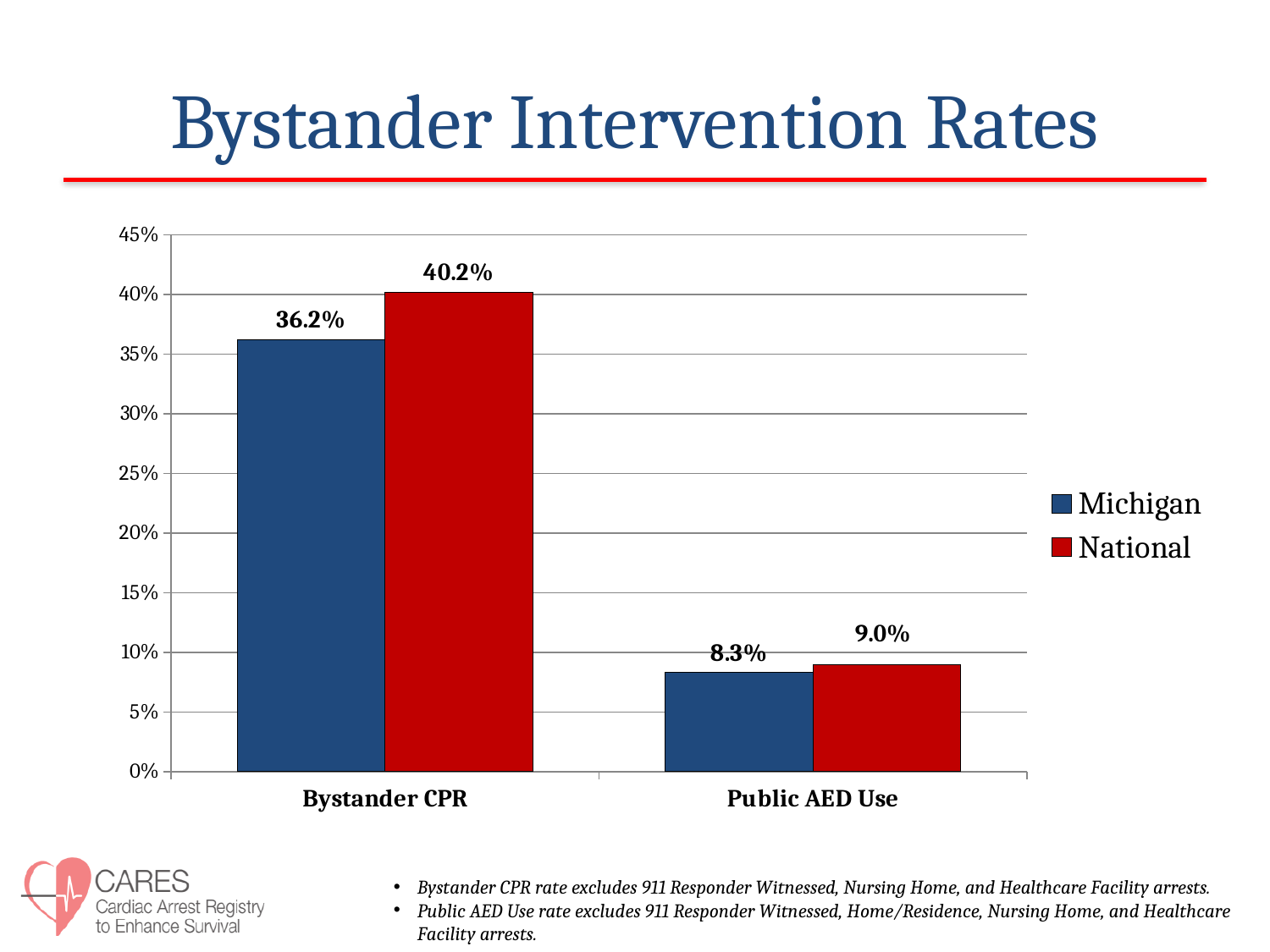
What is the Michigan value for Bystander CPR? 36.2% How many categories are shown on the x axis? 2 Which bar has the lowest value on the chart? Michigan, Public AED Use How many series does the legend list? 2 What is the Michigan value for Public AED Use? 8.3% Which colour represents the National series in the legend? Red What is the National value for Public AED Use? 9.0% What is the difference between the National and Michigan values for Bystander CPR? 4.0% Which bar has the highest value on the chart? National, Bystander CPR What kind of chart is shown on the slide? Bar chart What is the National value for Bystander CPR? 40.2% Which is larger for Public AED Use, Michigan or National? National